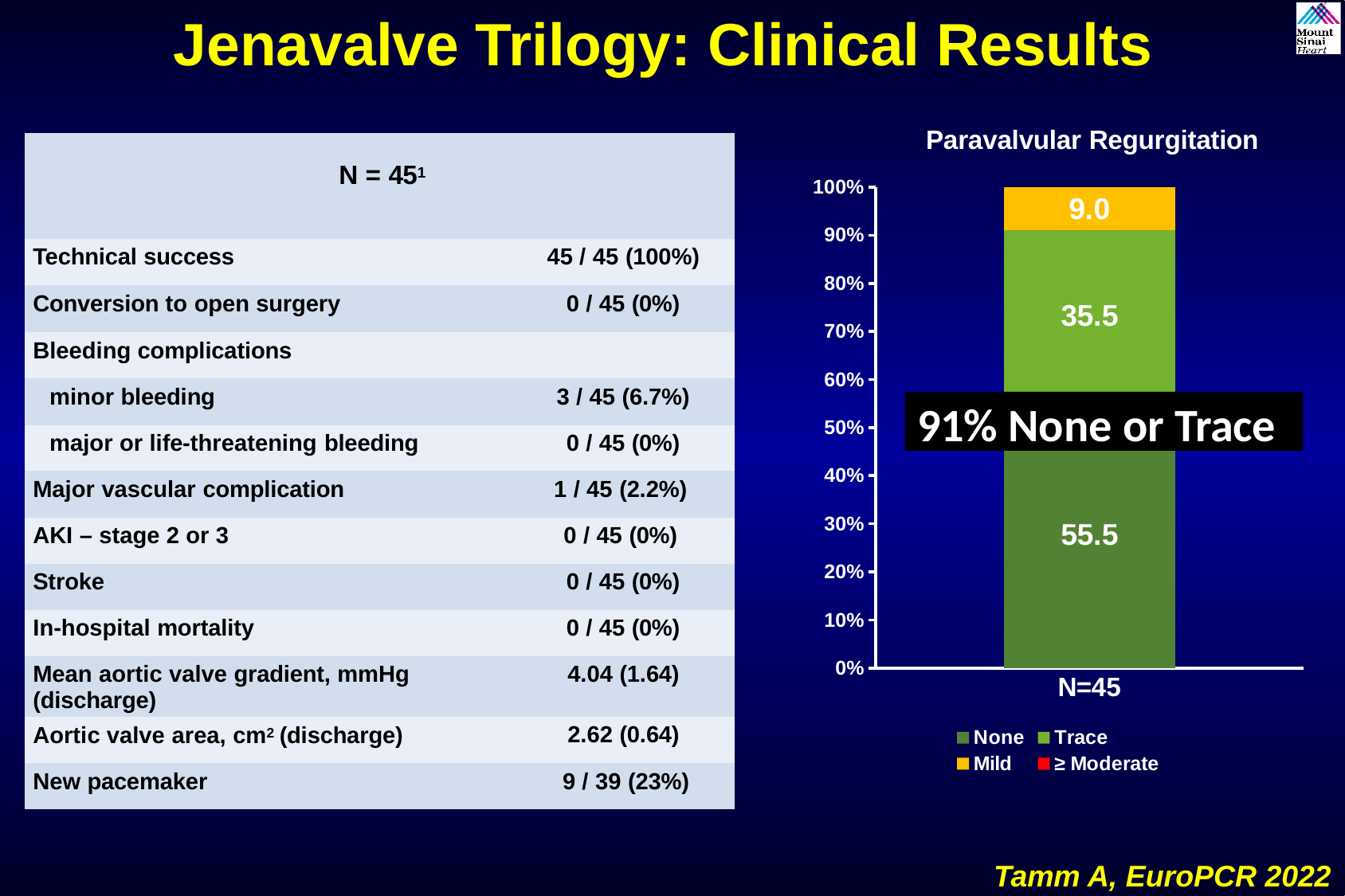
What is the combined value of the None and Trace segments? 91 What kind of chart is shown on the slide? stacked bar chart What is the value of the Trace segment in the Paravalvular Regurgitation chart? 35.5 Which labelled segment of the bar has the smallest value? Mild What is the difference between the None and Trace values? 20.0 What is the title of the chart? Paravalvular Regurgitation Which is larger, the Trace value or the Mild value? Trace How many series does the legend list? 4 Which segment of the bar has the largest value? None What is the category label under the bar? N=45 What is the value of the Mild segment in the Paravalvular Regurgitation chart? 9.0 What is the value of the None segment in the Paravalvular Regurgitation chart? 55.5